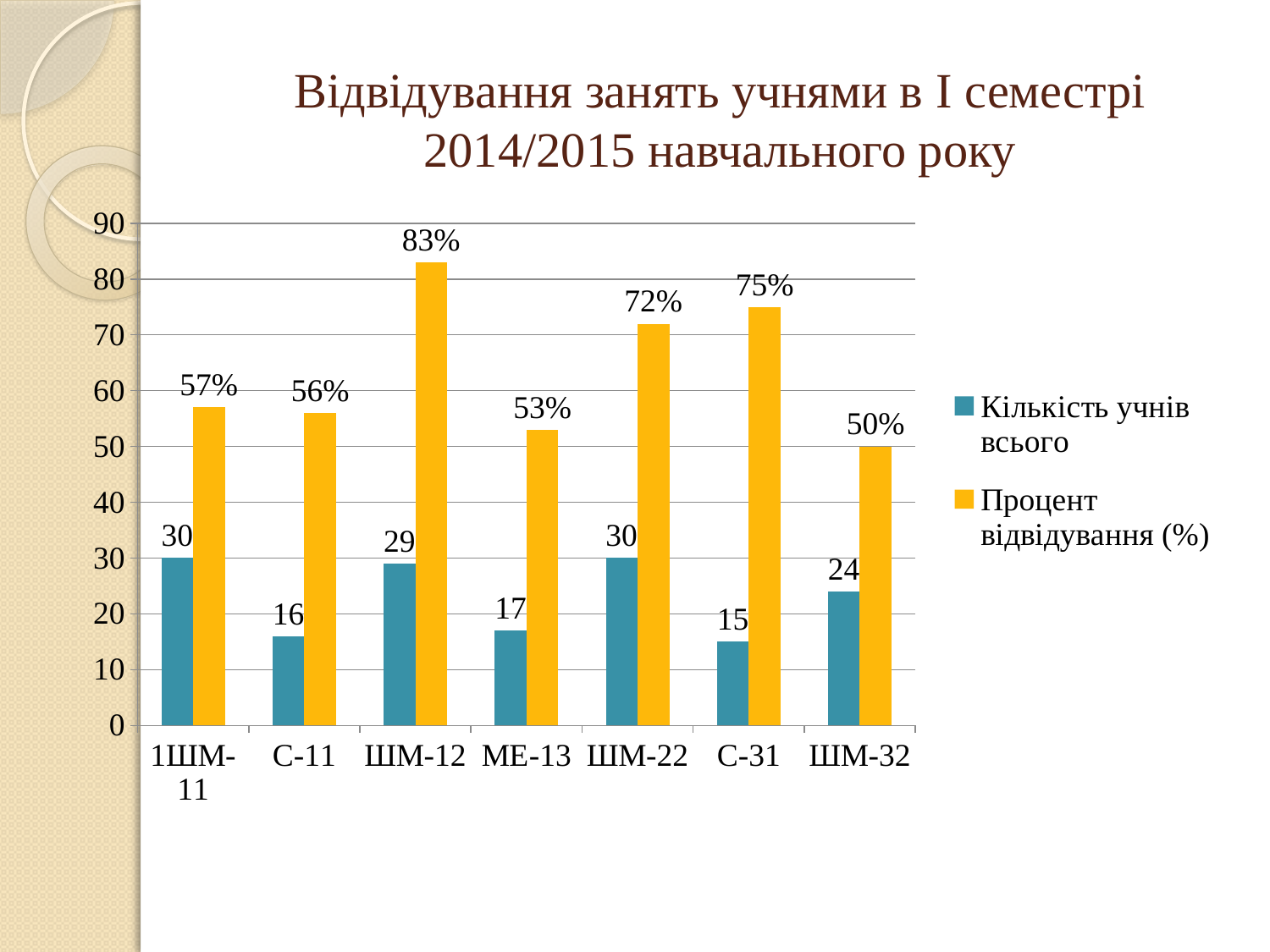
What is the difference in total number of students between 1ШМ-11 and С-11? 14 What is the attendance percentage for МЕ-13? 53% How many groups are shown on the x axis? 7 Which group has the lowest total number of students? С-31 What is the total number of students (Кількість учнів всього) for С-31? 15 Which group has the lowest attendance percentage? ШМ-32 Which group has a higher attendance percentage, ШМ-22 or С-31? С-31 How many series does the legend list? 2 What is the attendance percentage (Процент відвідування) for ШМ-12? 83% Which colour represents the series 'Процент відвідування (%)'? Yellow What kind of chart is shown on the slide? Bar chart Which group has the highest attendance percentage? ШМ-12